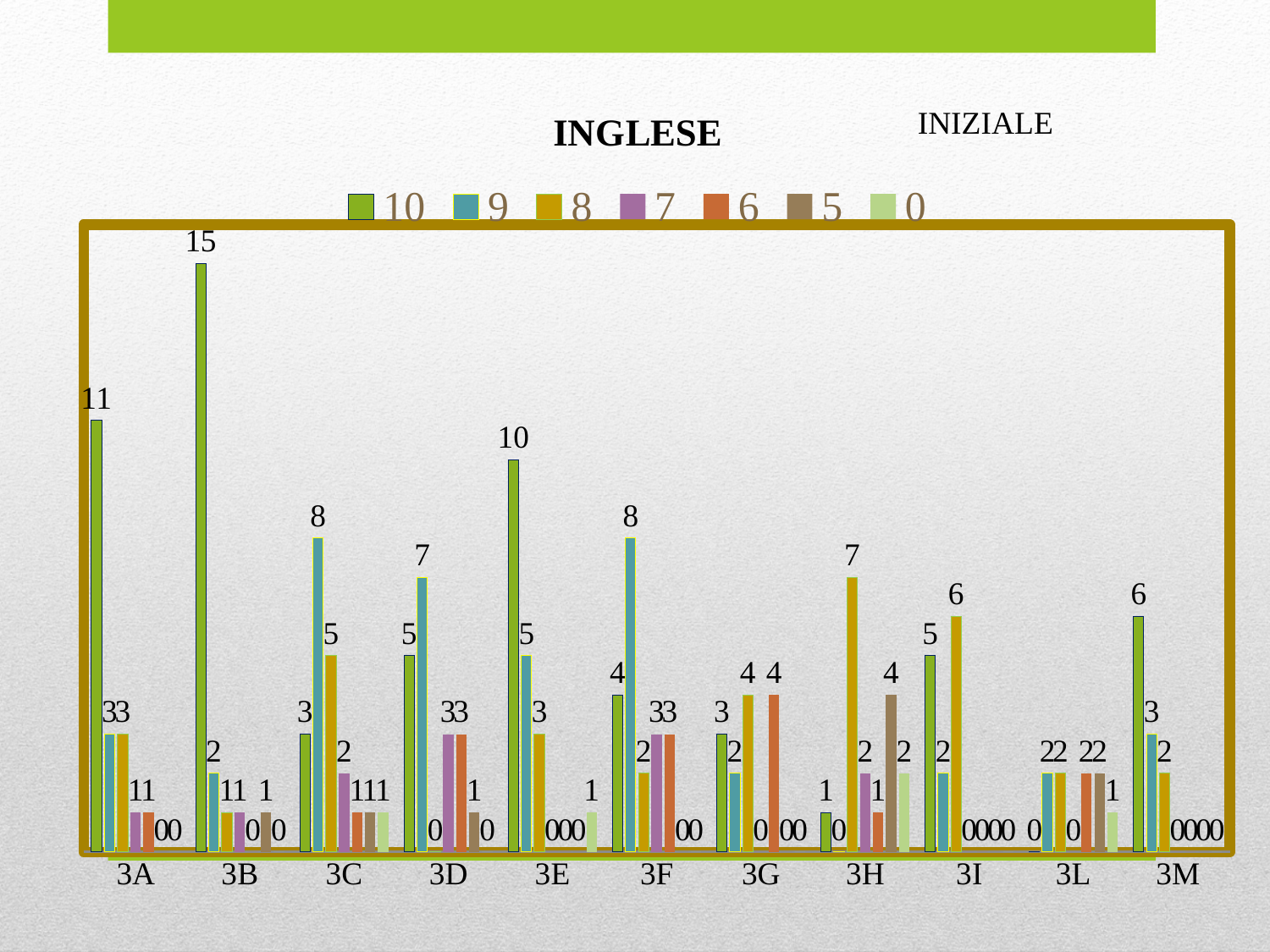
How many series does the legend list? 7 What is the value of the "10" series for class 3B? 15 What is the difference between the "10" series values for 3B and 3A? 4 Which class has the highest value in the "10" series? 3B What is the value of the "9" series for class 3C? 8 What is the value of the "8" series for class 3H? 7 What is the title of the chart? INGLESE What is the value of the "10" series for class 3E? 10 Which is larger: the "8" series value for 3I or the "8" series value for 3M? 3I What is the value of the "5" series for class 3H? 4 What kind of chart is shown? bar chart How many classes are shown on the x axis? 11